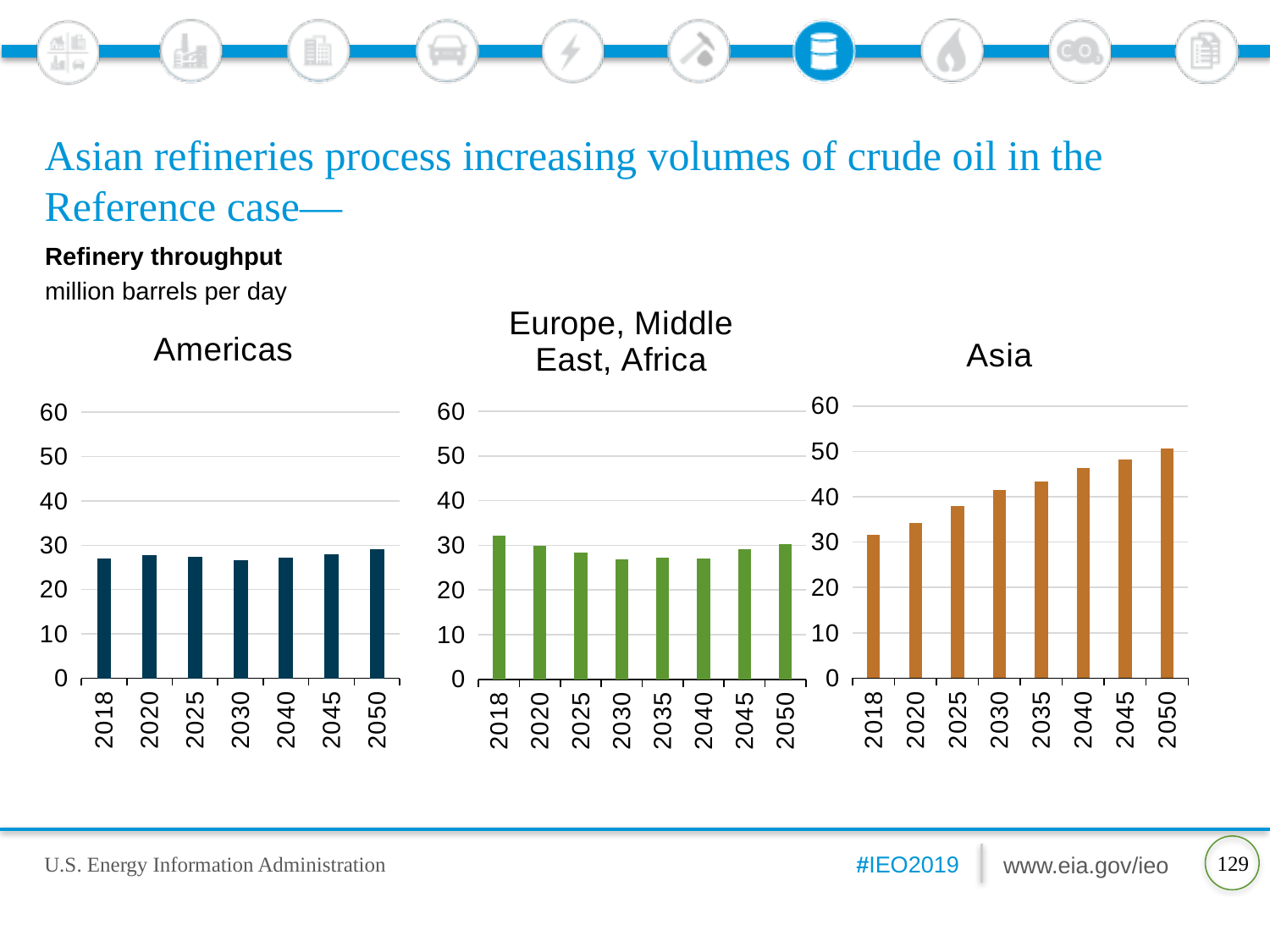
In the Asia chart, do the values rise or fall from 2018 to 2050? rise What kind of chart is the Asia chart? bar chart In the Europe, Middle East, Africa chart, which year has the highest refinery throughput? 2018 In the Asia chart, which year has the highest refinery throughput? 2050 What unit is used for refinery throughput on the slide? million barrels per day How many years are shown on the x axis of the Asia chart? 8 In the Americas chart, is the value for 2030 greater or less than 30? less In the Asia chart, is the value for 2025 greater or less than 40? less In the Europe, Middle East, Africa chart, is the value for 2030 greater or less than 30? less How many years are shown on the x axis of the Americas chart? 7 In the Asia chart, which year has the lowest refinery throughput? 2018